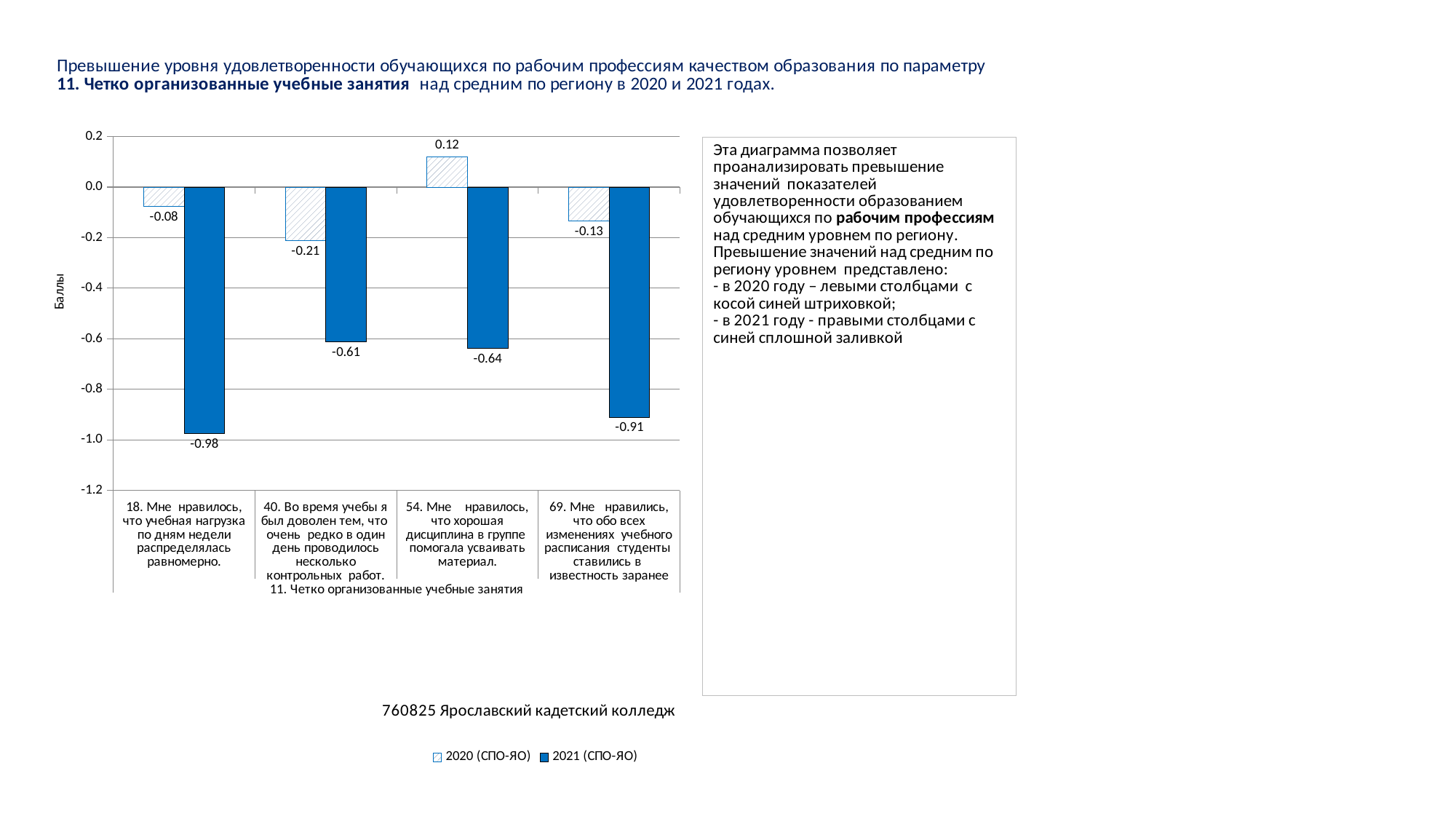
What is the 2020 (СПО-ЯО) value for question 54 (Мне нравилось, что хорошая дисциплина в группе помогала усваивать материал)? 0.12 Which category has the highest 2020 (СПО-ЯО) value? 54. Мне нравилось, что хорошая дисциплина в группе помогала усваивать материал. Which is larger for question 69: the 2020 (СПО-ЯО) value or the 2021 (СПО-ЯО) value? 2020 (СПО-ЯО) What is the 2021 (СПО-ЯО) value for question 18 (Мне нравилось, что учебная нагрузка по дням недели распределялась равномерно)? -0.98 What is the label of the y axis? Баллы How many categories (questions) are shown on the x axis? 4 What type of chart is shown on the slide? bar chart What is the 2021 (СПО-ЯО) value for question 69 (Мне нравились, что обо всех изменениях учебного расписания студенты ставились в известность заранее)? -0.91 What is the difference between the 2020 and 2021 values for question 54? 0.76 What is the 2020 (СПО-ЯО) value for question 40 (Во время учебы я был доволен тем, что очень редко в один день проводилось несколько контрольных работ)? -0.21 How many series does the legend list? 2 Which category has the lowest 2021 (СПО-ЯО) value? 18. Мне нравилось, что учебная нагрузка по дням недели распределялась равномерно.